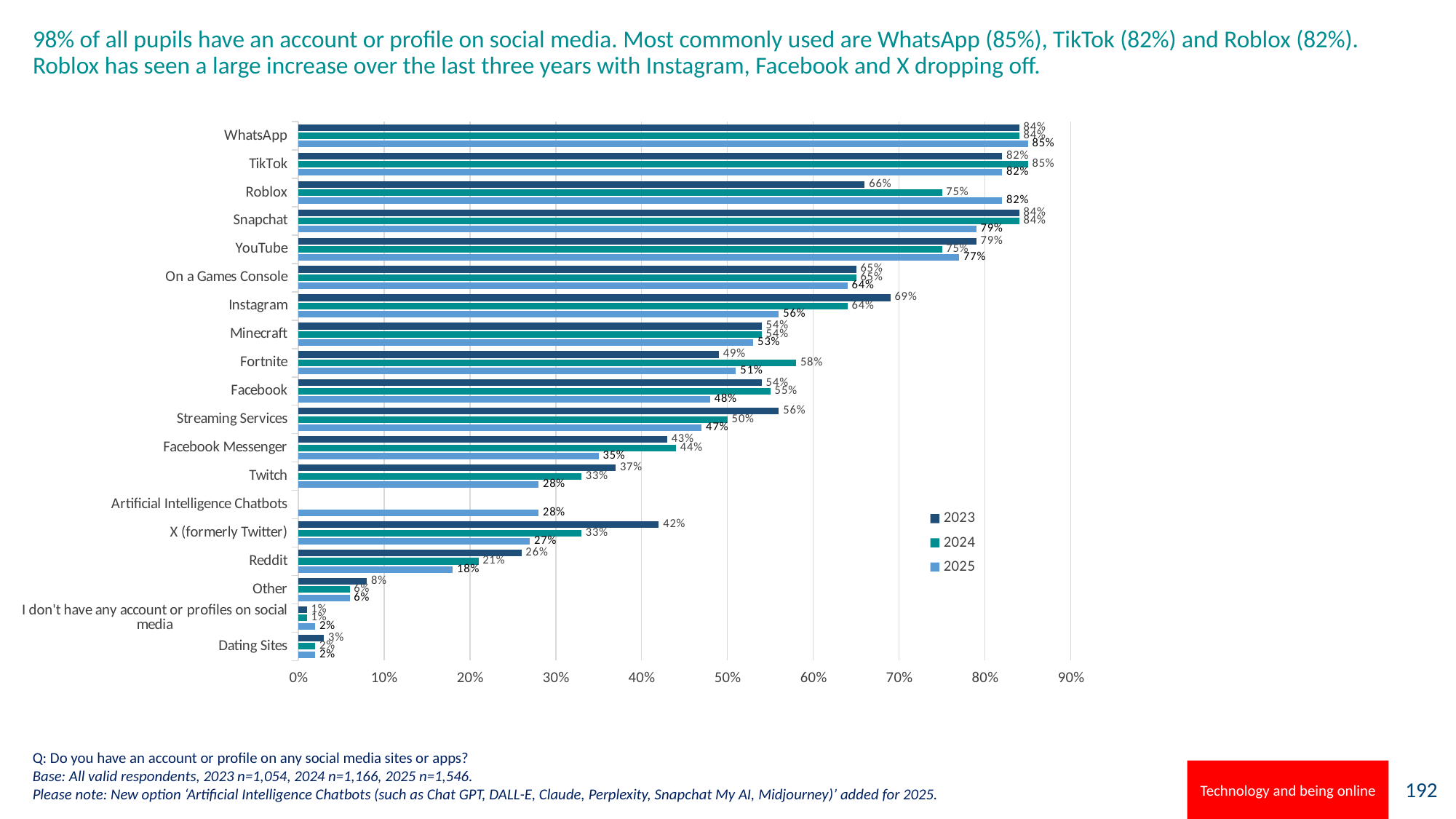
What is the 2024 value for Fortnite? 58% Which is larger for Roblox: the 2023 value or the 2025 value? 2025 What is the 2025 value for Artificial Intelligence Chatbots? 28% What is the 2023 value for Instagram? 69% How many categories are shown on the chart? 19 What is the difference between the 2023 and 2025 values for X (formerly Twitter)? 15% Which category has the highest 2025 value? WhatsApp How many series does the legend list? 3 What is the 2025 value for Roblox? 82% Do the values for Reddit rise or fall from 2023 to 2025? fall What kind of chart is shown on the slide? bar chart Which category has the lowest 2023 value? I don't have any account or profiles on social media